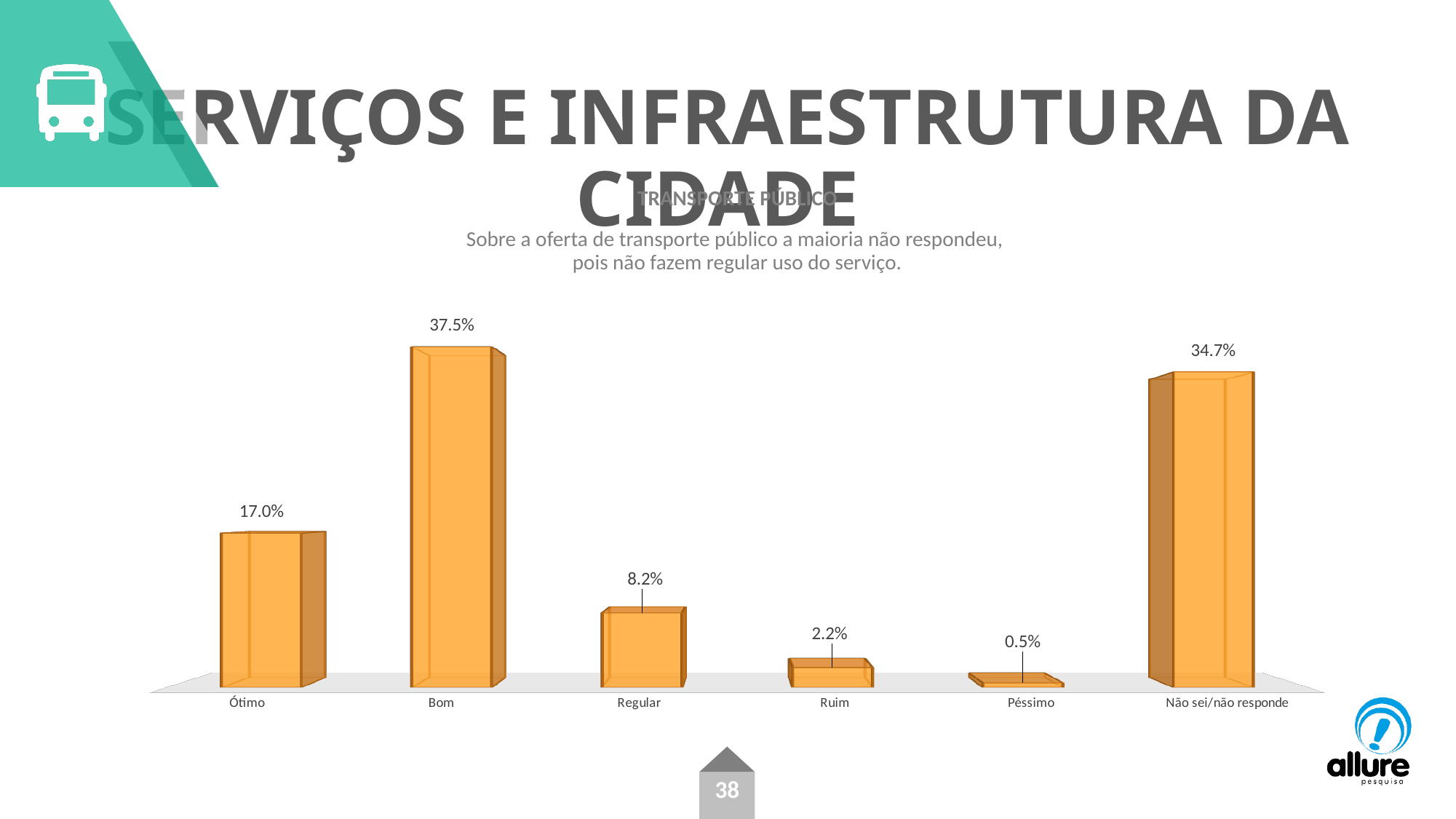
What is the value for Não sei/não responde? 34.7% What is the difference between the values for Ótimo and Regular? 8.8% What kind of chart is shown on the slide? Bar chart What colour are the bars in the chart? Orange What is the difference between the values for Bom and Não sei/não responde? 2.8% Which category has the lowest value? Péssimo What is the value for Ótimo? 17.0% What is the value for Péssimo? 0.5% How many categories are shown on the x axis? 6 Which is larger, the value for Regular or the value for Ruim? Regular Which category has the highest value? Bom What is the value for Bom? 37.5%